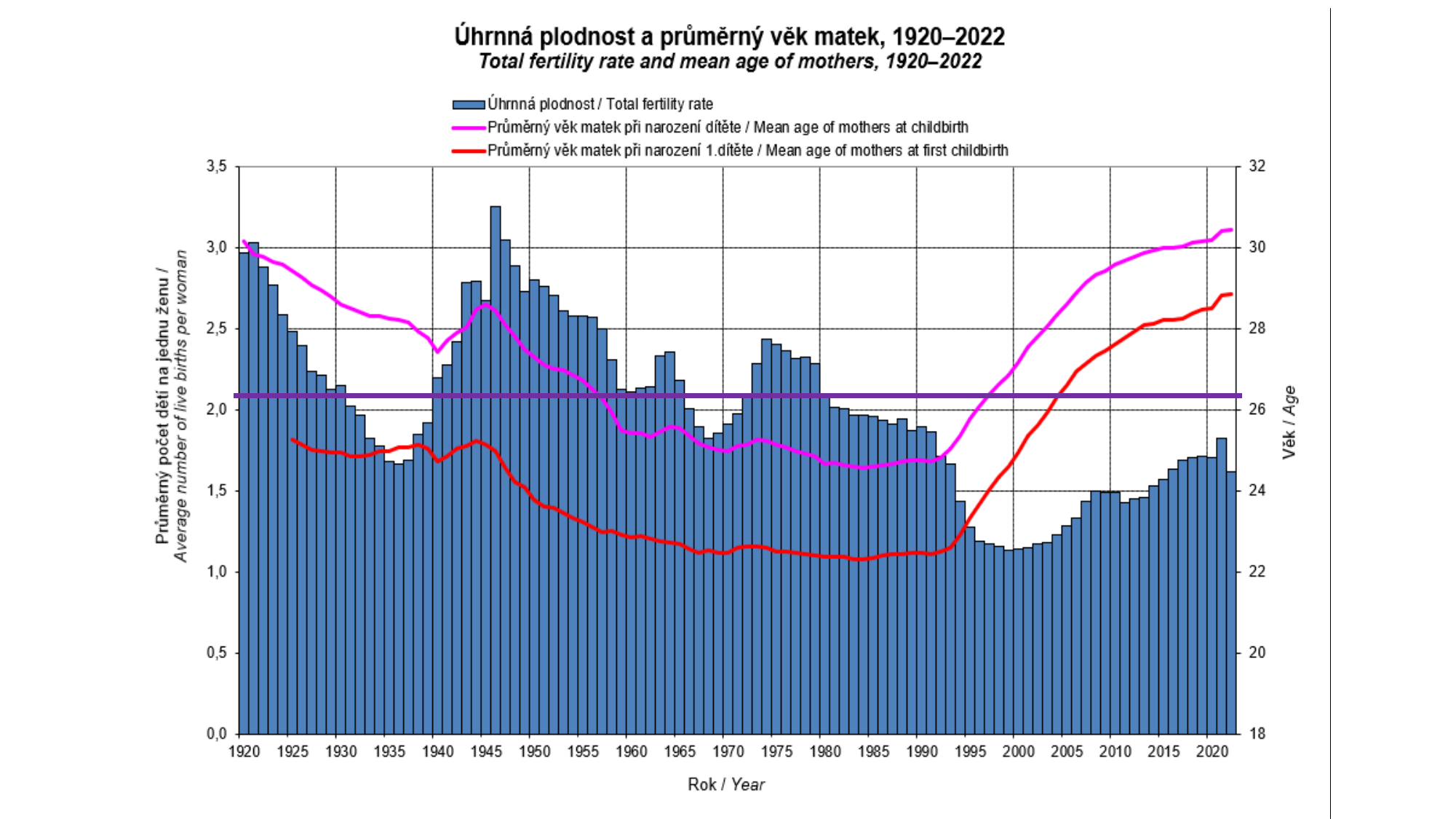
Which is larger, the total fertility rate in 1946 or in 1974? 1946 Is the mean age of mothers at first childbirth in 1985 greater or less than 24? less Is the mean age of mothers at childbirth in 2022 greater or less than 30? greater Does the total fertility rate rise or fall between 1920 and 1935? fall Is the total fertility rate in 1999 greater or less than 1,5? less What is the label of the x axis? Rok / Year What kind of chart is shown on the slide? A combined bar and line chart How many series does the legend list? 3 In which year is the total fertility rate highest? 1946 Does the mean age of mothers at first childbirth rise or fall between 1995 and 2022? rise